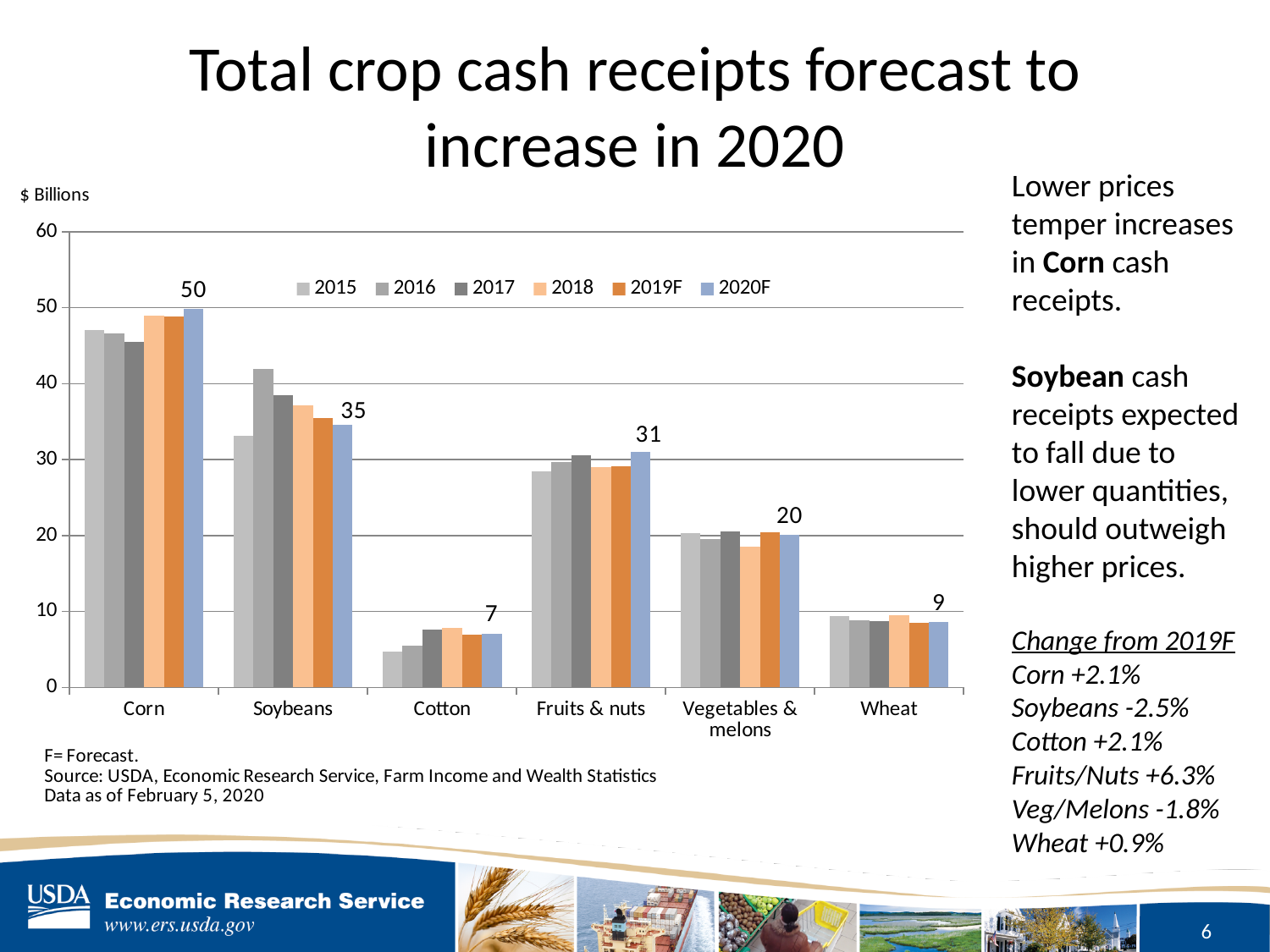
How many crop categories are shown on the x axis? 6 Is the 2015 value for Soybeans greater or less than 40? less What is the 2020F value for Fruits & nuts? 31 Which category has the lowest 2020F value? Cotton How many series does the legend list? 6 Which category has the highest 2020F value? Corn What is the difference between the 2020F values for Corn and Soybeans? 15 What is the 2020F value for Corn? 50 What is the 2020F value for Cotton? 7 What kind of chart is shown on the slide? Bar chart Which is larger, the 2020F value for Vegetables & melons or for Wheat? Vegetables & melons What is the 2020F value for Soybeans? 35